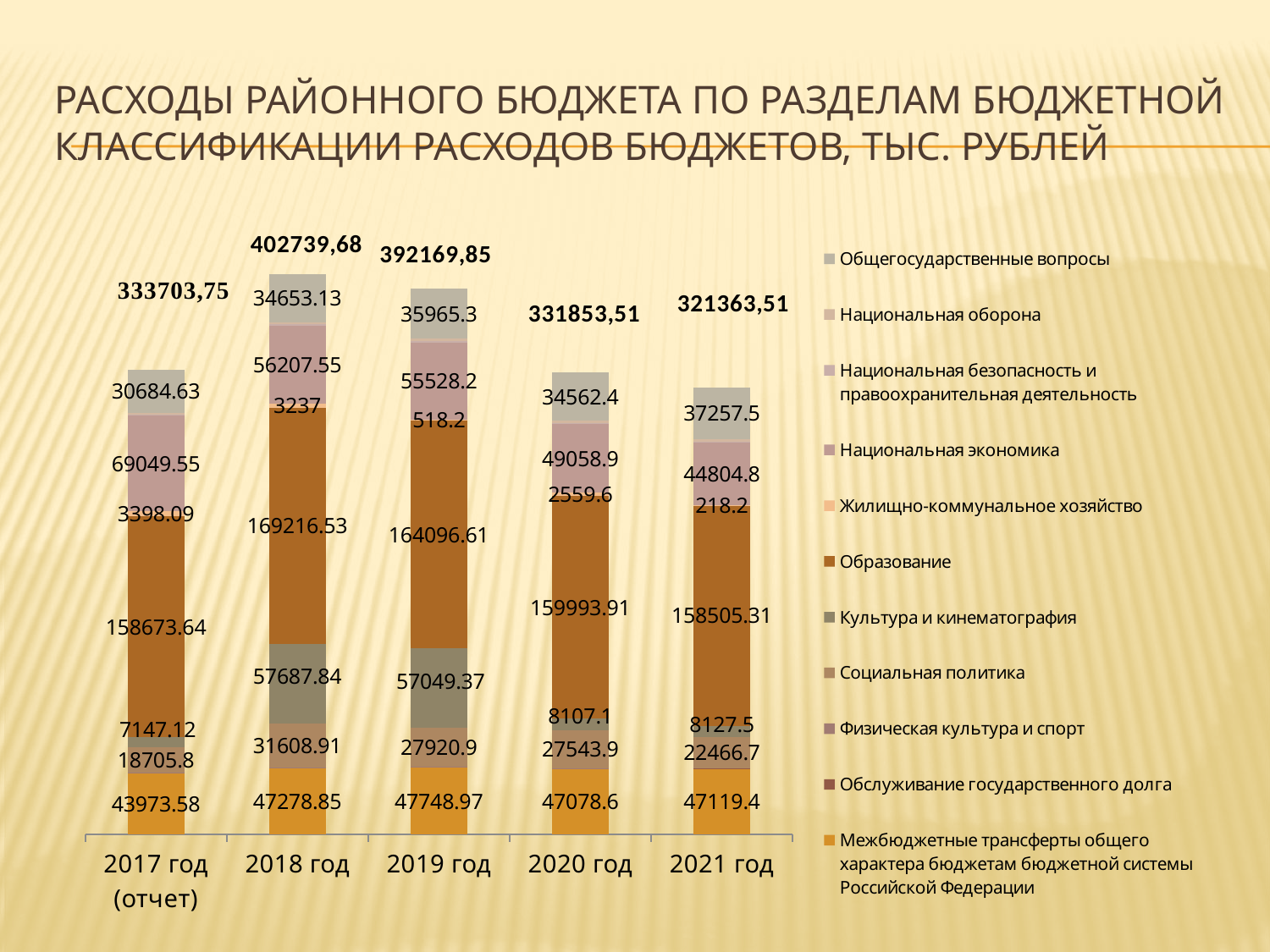
Which year has the lowest total expenditure? 2021 год Which is larger: the Образование value for 2018 год or for 2020 год? 2018 год Is the total for 2019 год greater or less than the total for 2020 год? greater How many series does the legend list? 11 What is the title of the chart on the slide? Расходы районного бюджета по разделам бюджетной классификации расходов бюджетов, тыс. рублей What type of chart is shown on the slide? stacked bar chart Which year has the highest total expenditure? 2018 год What is the value of the Образование segment for 2019 год? 164096.61 What is the total expenditure shown above the bar for 2021 год? 321363,51 What is the total expenditure shown above the bar for 2018 год? 402739,68 What is the value of the bottom segment (Межбюджетные трансферты общего характера) for 2017 год (отчет)? 43973.58 How many years (categories) are shown on the x axis? 5